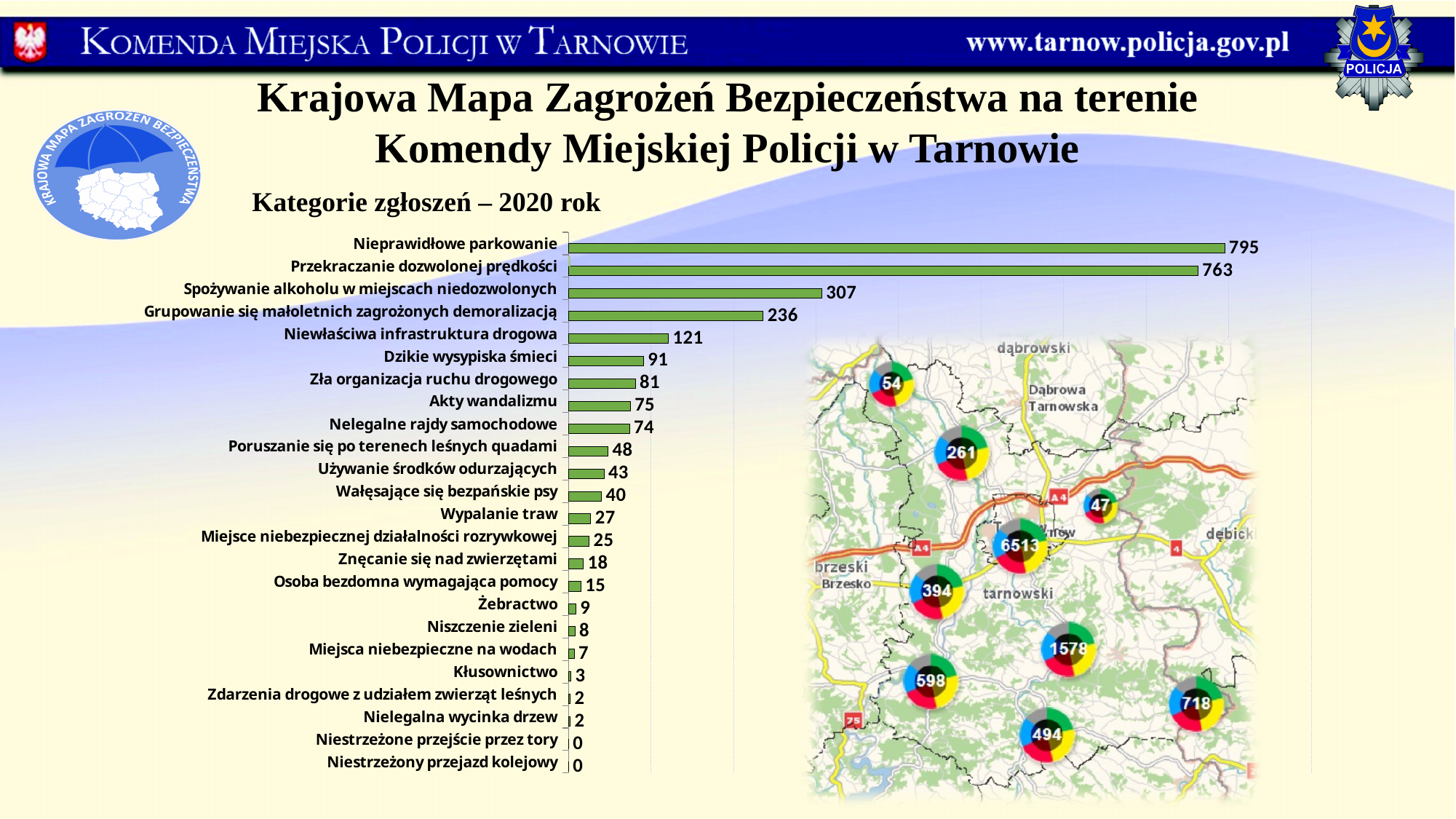
What is the value for Spożywanie alkoholu w miejscach niedozwolonych? 307 Which category has the highest value? Nieprawidłowe parkowanie What is the difference between Nieprawidłowe parkowanie and Przekraczanie dozwolonej prędkości? 32 What is the value for Wałęsające się bezpańskie psy? 40 What is the difference between Spożywanie alkoholu w miejscach niedozwolonych and Grupowanie się małoletnich zagrożonych demoralizacją? 71 What is the subtitle above the bar chart? Kategorie zgłoszeń – 2020 rok What is the value for Kłusownictwo? 3 How many categories are shown in the bar chart? 24 Which is larger, Akty wandalizmu or Poruszanie się po terenach leśnych quadami? Akty wandalizmu What is the value for Dzikie wysypiska śmieci? 91 What kind of chart is shown on the slide? bar chart What is the value for Nieprawidłowe parkowanie? 795